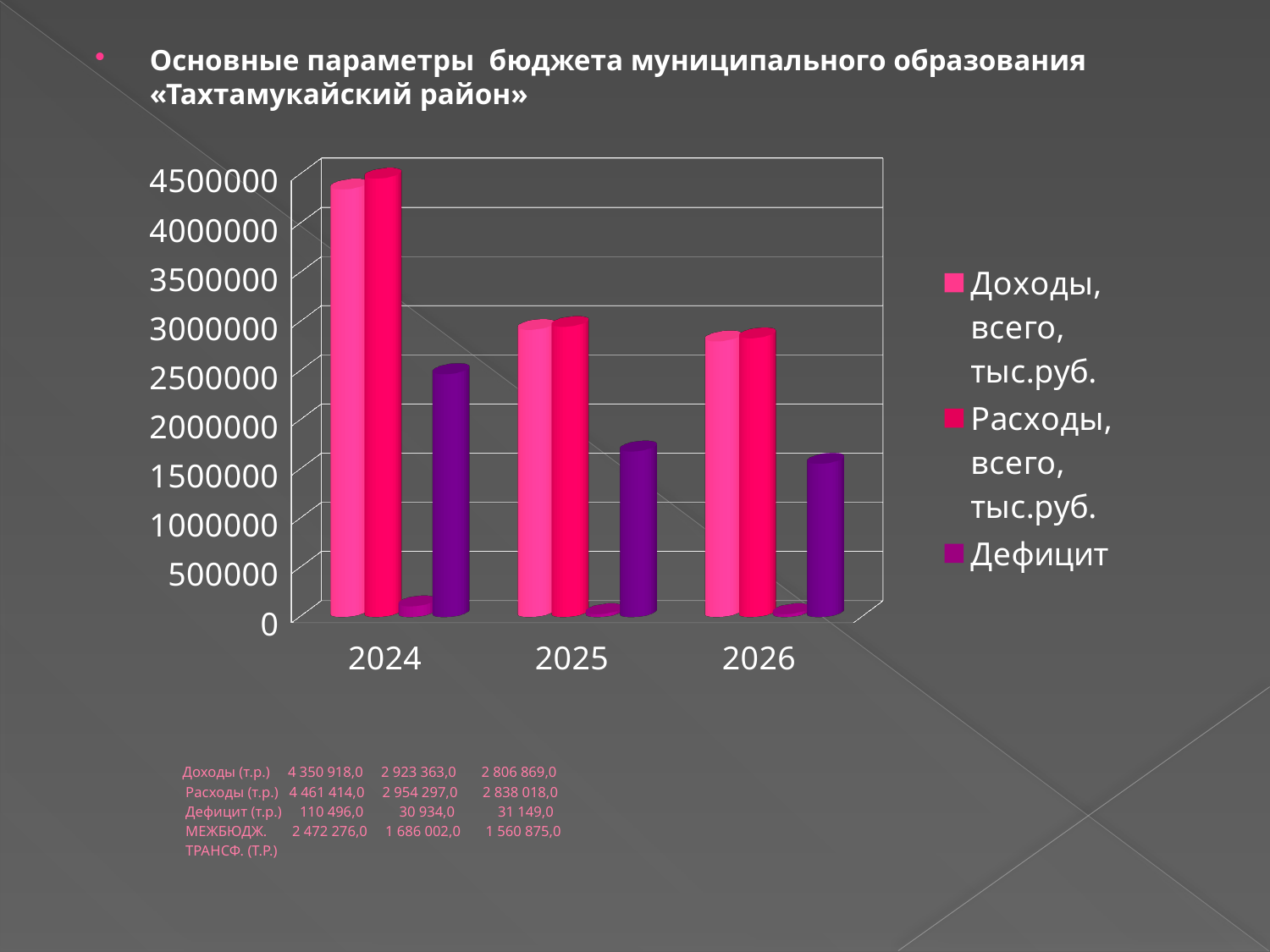
In 2024, which is larger: Доходы, всего, тыс.руб. or Расходы, всего, тыс.руб.? Расходы, всего, тыс.руб. According to the figures printed below the chart, what is the value of Доходы (т.р.) for 2024? 4 350 918,0 Which year has the highest value for Доходы, всего, тыс.руб.? 2024 Which year has the lowest value for Расходы, всего, тыс.руб.? 2026 How many series does the chart legend list? 3 Is the value for Расходы, всего, тыс.руб. in 2026 greater or less than 2500000? greater Do the values for Доходы, всего, тыс.руб. rise or fall from 2024 to 2026? fall How many years (categories) are shown on the x axis of the chart? 3 What kind of chart is shown on the slide? bar chart Is the value for Доходы, всего, тыс.руб. in 2024 greater or less than 4000000? greater What is the title of the slide containing the chart? Основные параметры бюджета муниципального образования «Тахтамукайский район»